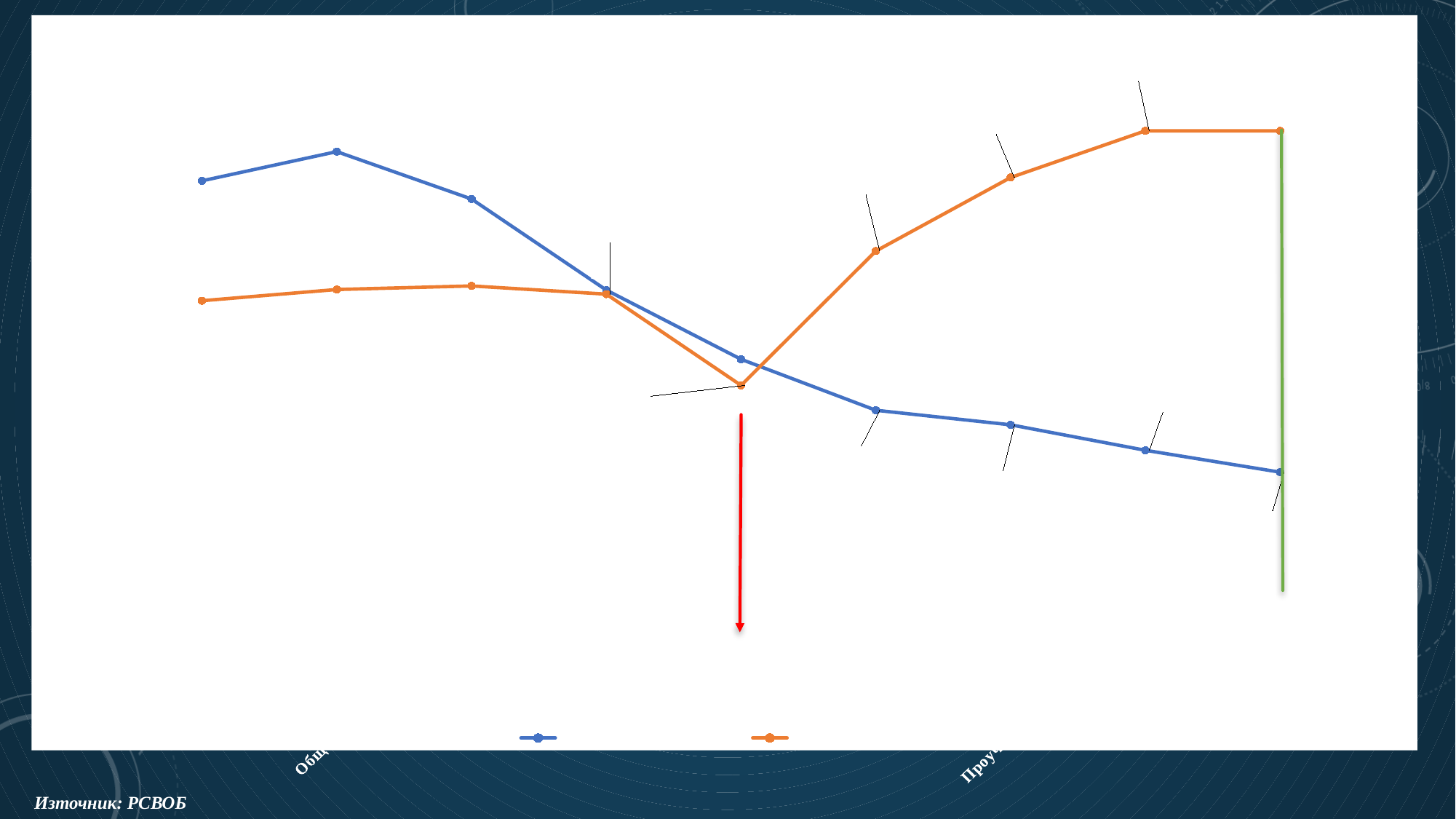
How many data points does the orange line have? 9 How many data points does the blue line have? 9 What colour is the arrow pointing downward below the chart? red At the leftmost point, which line is higher, the blue or the orange? blue Which line reaches the lowest point on the chart, the blue or the orange? blue How many series does the legend list? 2 At the rightmost point, which line is higher, the blue or the orange? orange Which line reaches the highest point on the chart, the blue or the orange? orange Does the blue line overall rise or fall from left to right? fall Does the orange line overall rise or fall from left to right? rise What source is cited at the bottom of the slide? РСВОБ What kind of chart is shown on the slide? line chart